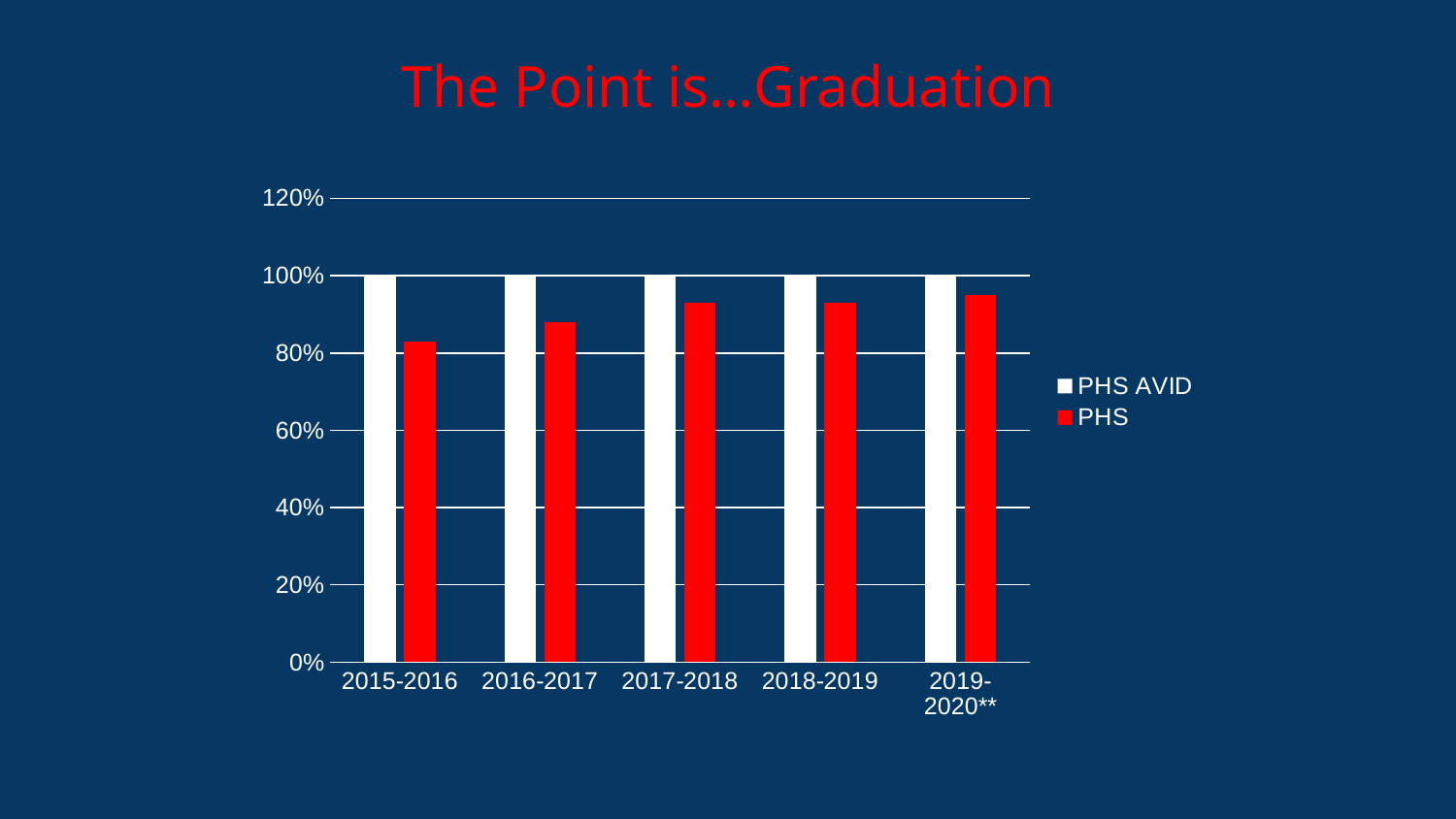
What is the value for PHS AVID in 2015-2016? 100% What is the title of the chart on the slide? The Point is…Graduation Do the PHS values generally rise or fall from 2015-2016 to 2019-2020**? rise Is the value for PHS in 2019-2020** greater or less than 100%? less What kind of chart is shown on the slide? bar chart Is the value for PHS in 2015-2016 greater or less than 80%? greater What is the value for PHS AVID in 2019-2020**? 100% In 2015-2016, which is larger, PHS AVID or PHS? PHS AVID Which colour represents the PHS series in the legend? red How many school-year categories are shown on the x axis? 5 Which school year has the lowest value for PHS? 2015-2016 How many series does the legend list? 2